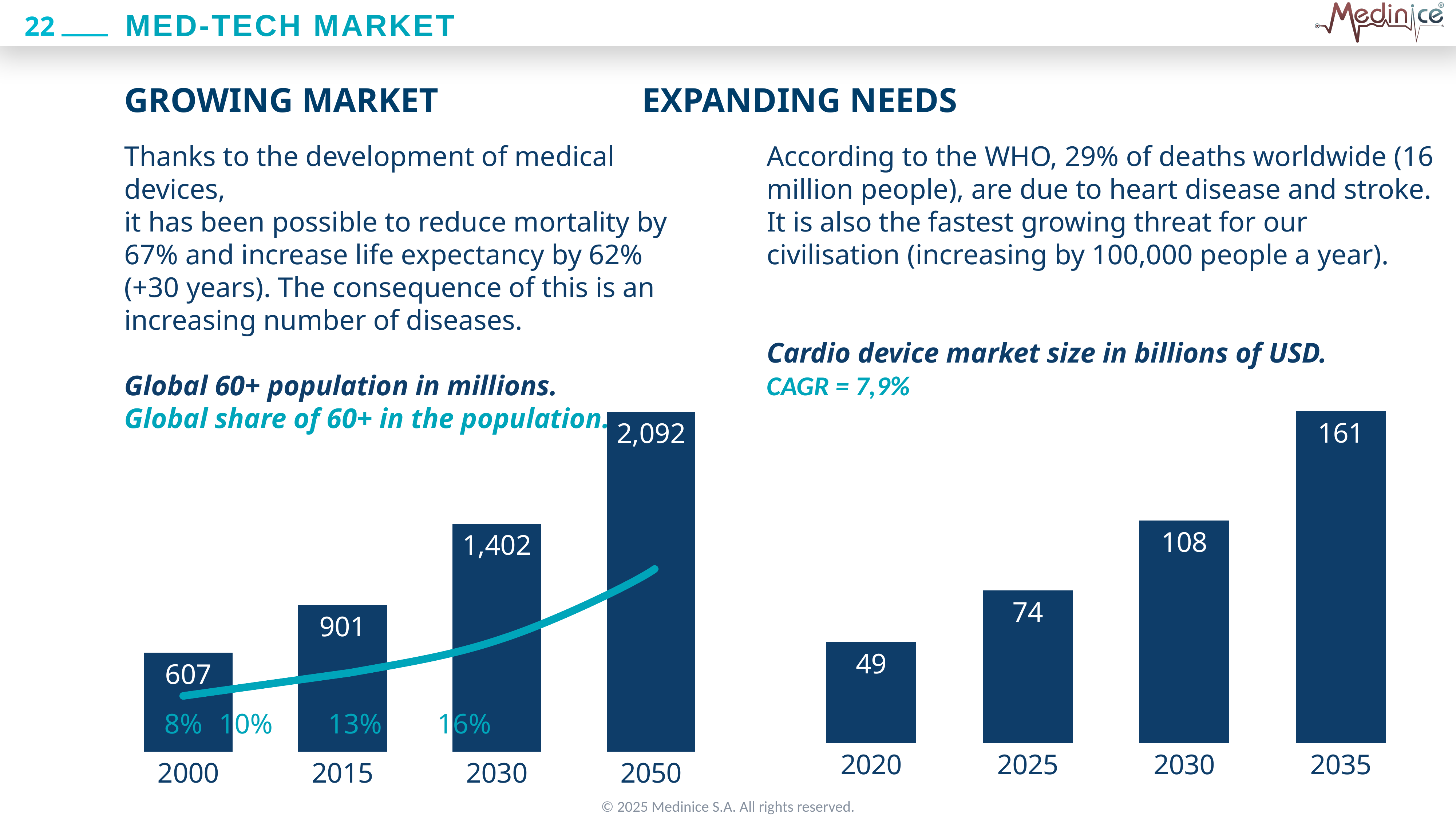
In the 'Cardio device market size in billions of USD' chart, which year has the highest value? 2035 In the 'Cardio device market size in billions of USD' chart, what is the value for 2025? 74 What CAGR is stated for the 'Cardio device market size in billions of USD' chart? 7,9% In the 'Cardio device market size in billions of USD' chart, what is the value for 2035? 161 In the 'Global 60+ population in millions' chart, what is the value for 2050? 2,092 In the 'Global 60+ population in millions' chart, how many years are shown on the x axis? 4 In the 'Cardio device market size in billions of USD' chart, which is larger, the value for 2025 or the value for 2030? 2030 In the 'Global 60+ population in millions' chart, do the bar values rise or fall from 2000 to 2050? rise In the 'Cardio device market size in billions of USD' chart, what is the difference between the 2030 and 2020 values? 59 In the 'Global 60+ population in millions' chart, what is the difference between the 2030 and 2000 values? 795 In the 'Global 60+ population in millions' chart, which year has the lowest value? 2000 In the 'Global 60+ population in millions' chart, what is the value for 2015? 901